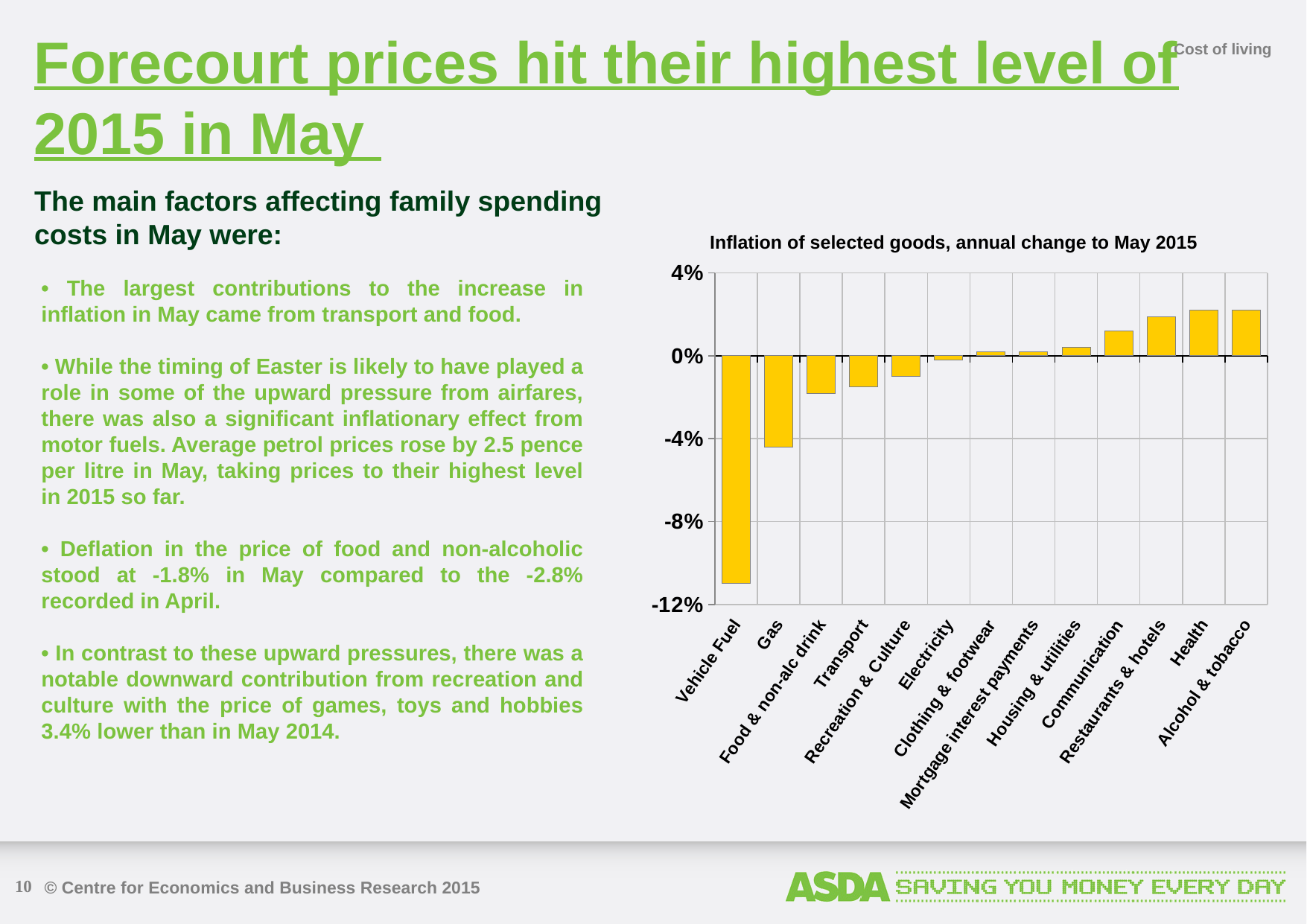
What kind of chart is shown on the slide? Bar chart How many categories in the chart have a negative value? 6 Do the values generally rise or fall moving from left to right along the x axis? Rise Is the value for Vehicle Fuel greater or less than -8%? less Which is larger, the value for Communication or the value for Restaurants & hotels? Restaurants & hotels How many categories are plotted in the chart? 13 Which category has the lowest value in the chart? Vehicle Fuel What is the title of the chart? Inflation of selected goods, annual change to May 2015 Which is larger, the value for Vehicle Fuel or the value for Gas? Gas Is the value for Communication greater or less than 4%? less Is the value for Health greater or less than 0%? greater